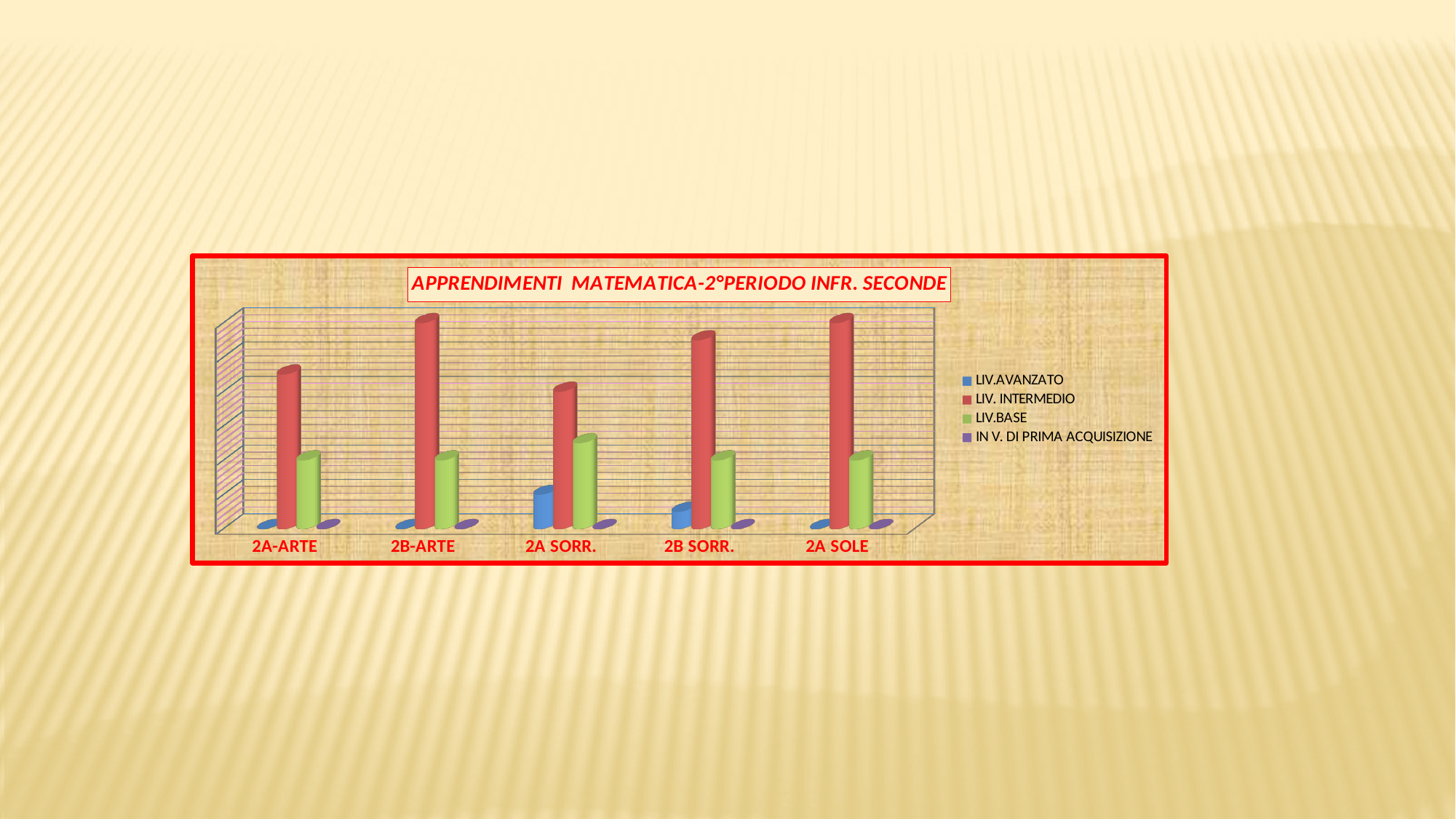
Which class has the lowest LIV. INTERMEDIO bar? 2A SORR. Which class has the larger LIV. INTERMEDIO bar: 2B-ARTE or 2A-ARTE? 2B-ARTE What kind of chart is shown on the slide? bar chart How many categories (classes) are shown on the x axis? 5 Which class has the highest LIV.AVANZATO bar? 2A SORR. Which is larger for 2A-ARTE: LIV. INTERMEDIO or LIV.BASE? LIV. INTERMEDIO How many series does the legend list? 4 What is the title of the chart? APPRENDIMENTI MATEMATICA-2°PERIODO INFR. SECONDE Which series is shown in red in the legend? LIV. INTERMEDIO Which class has the larger LIV. INTERMEDIO bar: 2A-ARTE or 2A SORR.? 2A-ARTE Which class has the highest LIV.BASE bar? 2A SORR.